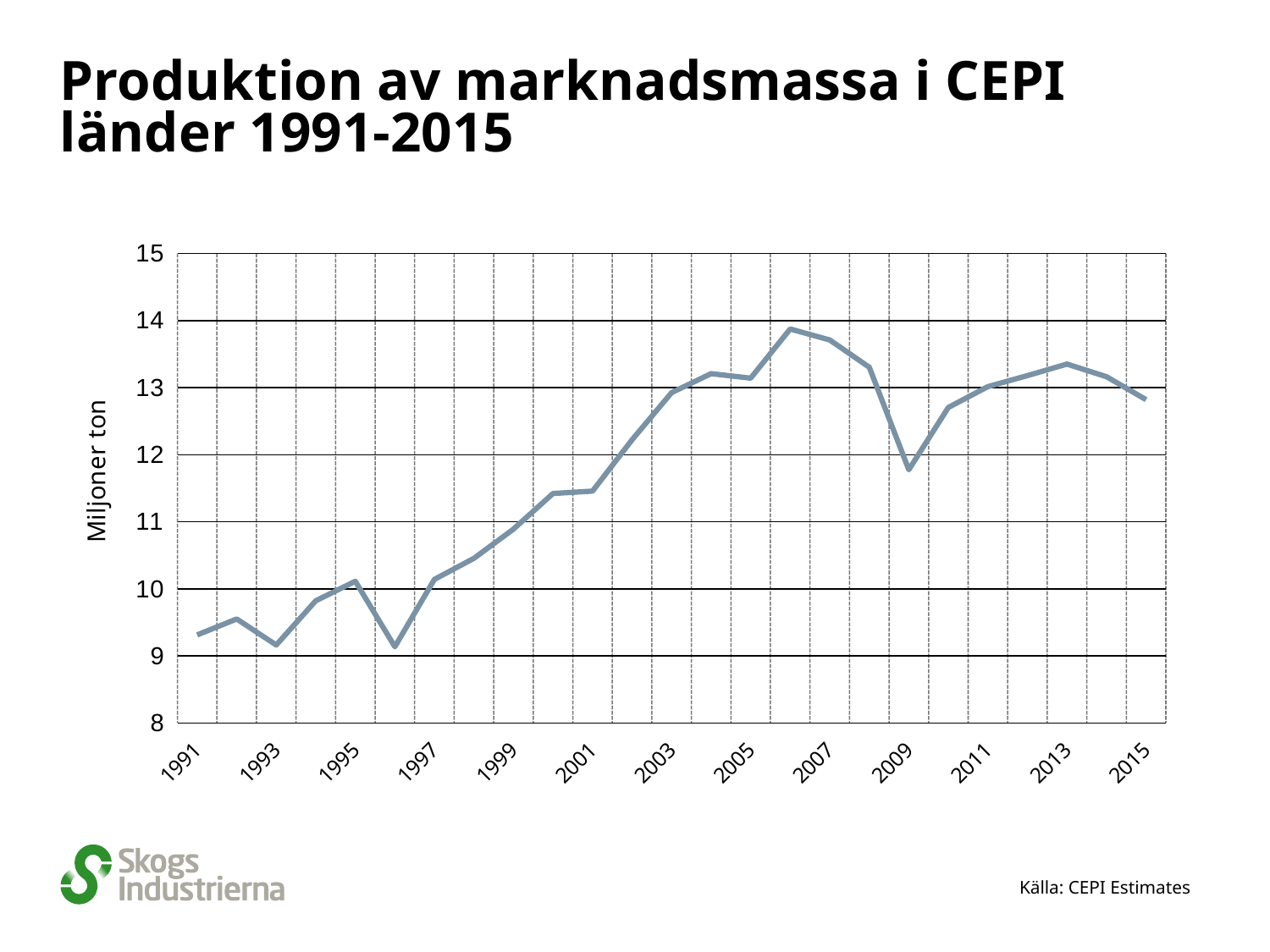
Which year has the larger value, 1991 or 2015? 2015 Is the value for 2009 greater or less than 12? less Is the value for 1991 greater or less than 10? less Is the value for 2015 greater or less than 13? less In which year does the line reach its highest value? 2006 Does the line generally rise or fall from 1991 to 2006? rise What source is cited for the chart? CEPI Estimates What is the label of the y axis? Miljoner ton Which year has the larger value, 2006 or 2009? 2006 What kind of chart is shown on the slide? line chart